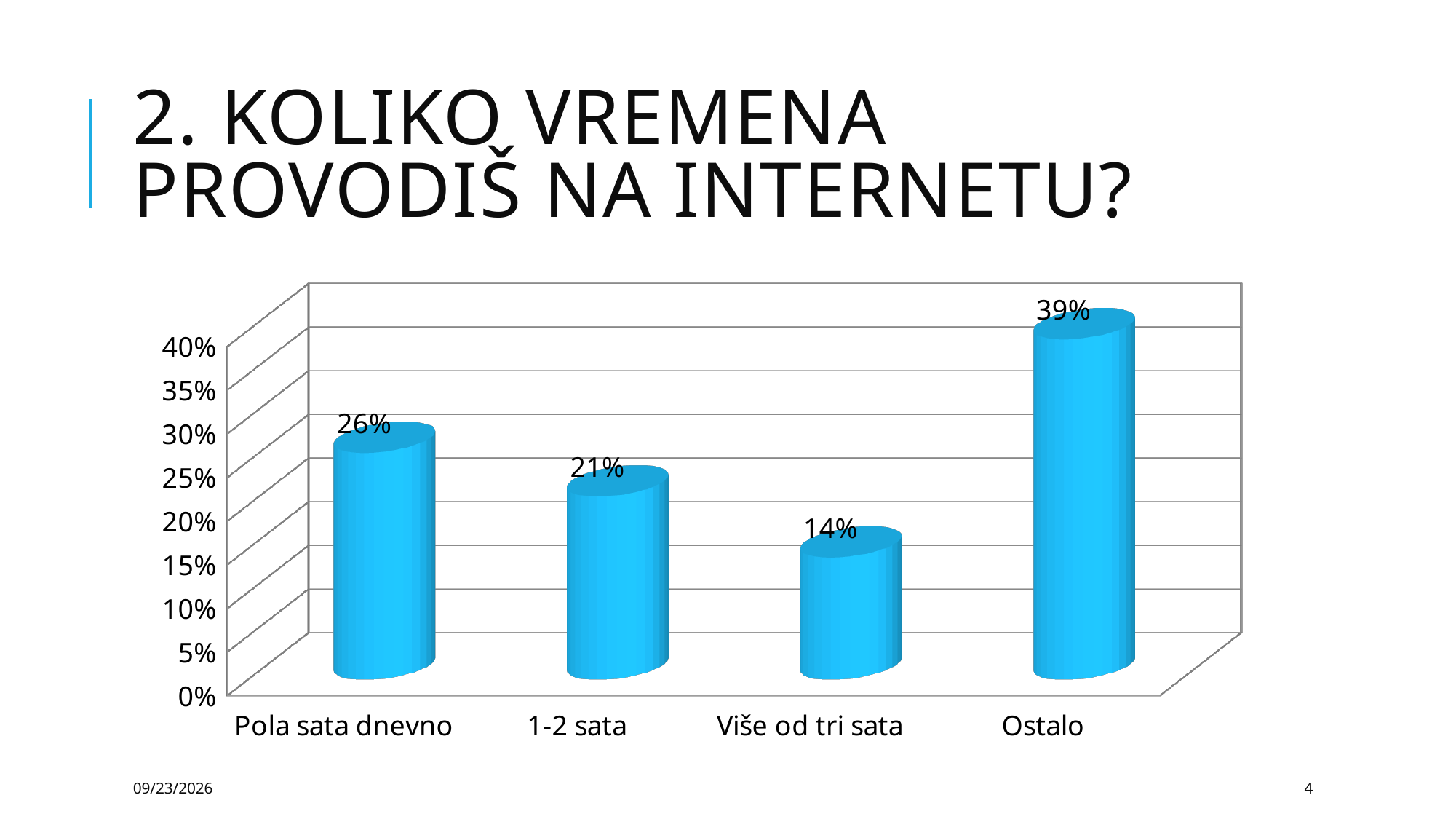
What is the value for "Više od tri sata"? 14% What is the value for "Pola sata dnevno"? 26% Which is larger, the value for "Pola sata dnevno" or the value for "1-2 sata"? Pola sata dnevno What is the value for "1-2 sata"? 21% How many categories are shown on the x axis? 4 What kind of chart is shown on the slide? Bar chart What is the title of the slide containing the chart? 2. KOLIKO VREMENA PROVODIŠ NA INTERNETU? What is the difference between the values for "1-2 sata" and "Više od tri sata"? 7% What is the value for "Ostalo"? 39% Which category has the lowest value? Više od tri sata What is the difference between the values for "Ostalo" and "Pola sata dnevno"? 13% Which category has the highest value? Ostalo